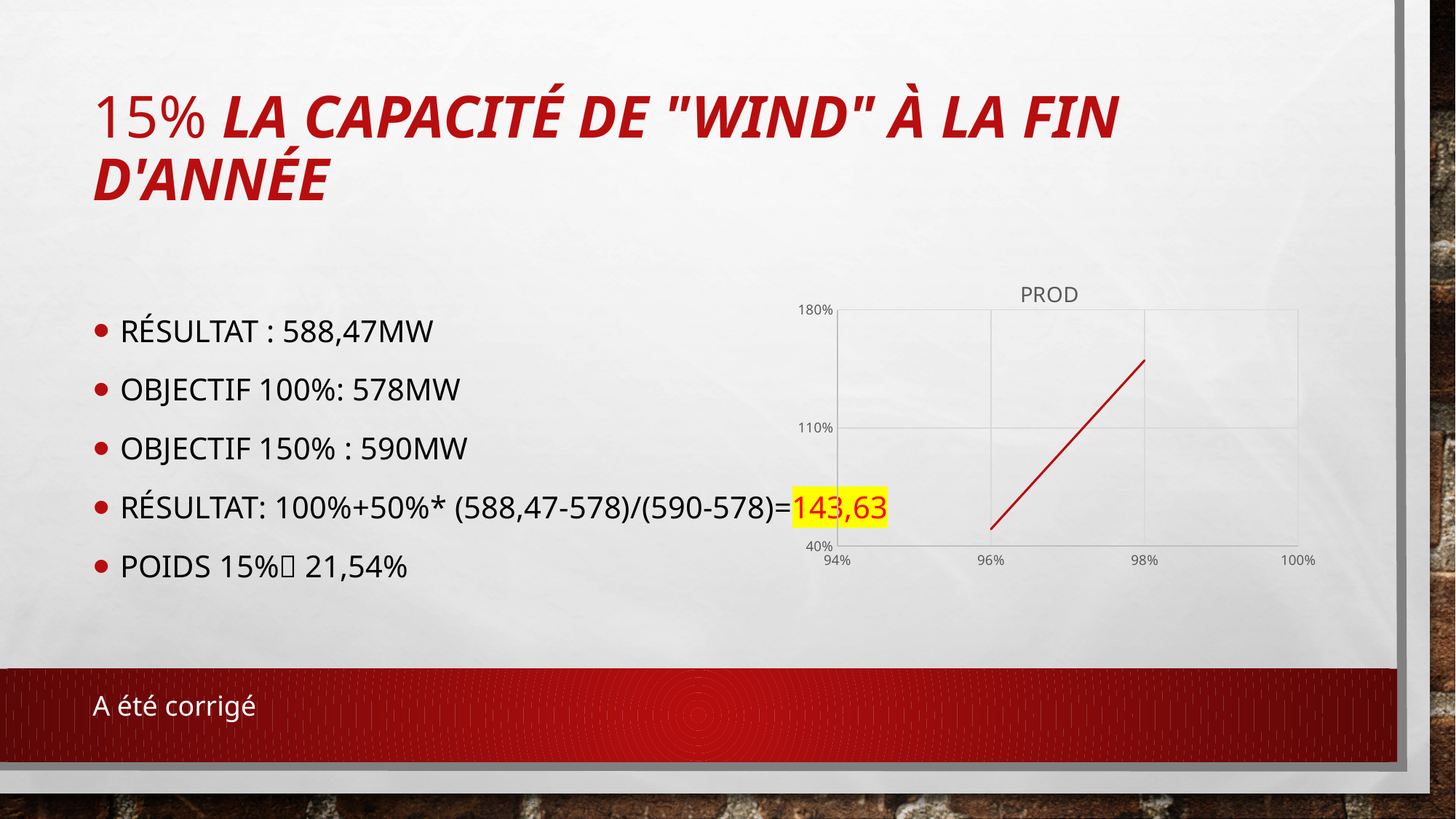
In the PROD chart, is the value at x = 98% greater or less than 110%? greater In the PROD chart, is the value at x = 96% greater or less than 40%? greater What is the title of the chart on the slide? PROD In the PROD chart, does the line rise or fall as the x-axis value increases from 96% to 98%? rises What kind of chart is the PROD chart? line chart In the PROD chart, is the value at x = 96% greater or less than 110%? less In the PROD chart, which x value has the higher plotted value, 96% or 98%? 98% What is the highest tick label shown on the y-axis of the PROD chart? 180%